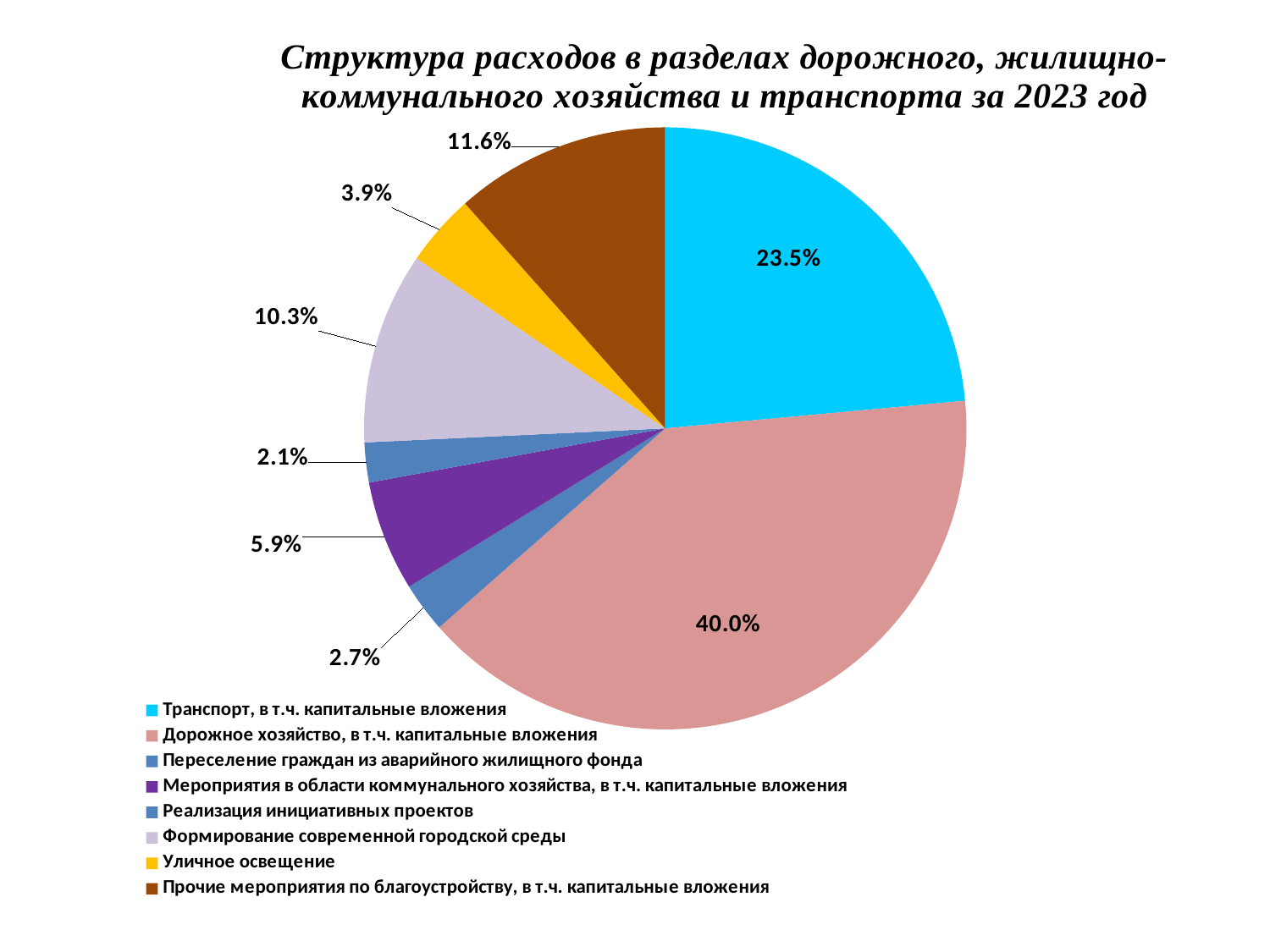
What colour is the slice for "Уличное освещение"? Yellow Which category has the largest share of expenses? Дорожное хозяйство, в т.ч. капитальные вложения What percentage is shown for "Уличное освещение"? 3.9% Which has a larger share: "Прочие мероприятия по благоустройству, в т.ч. капитальные вложения" or "Формирование современной городской среды"? Прочие мероприятия по благоустройству, в т.ч. капитальные вложения What is the difference in percentage points between "Дорожное хозяйство, в т.ч. капитальные вложения" and "Транспорт, в т.ч. капитальные вложения"? 16.5 What percentage is shown for "Реализация инициативных проектов"? 2.1% How many categories does the pie chart contain? 8 What type of chart is shown on the slide? Pie chart Which category has the smallest share of expenses? Реализация инициативных проектов What share of expenses does "Транспорт, в т.ч. капитальные вложения" account for? 23.5% What share of expenses does "Дорожное хозяйство, в т.ч. капитальные вложения" account for? 40.0% What percentage is shown for "Формирование современной городской среды"? 10.3%